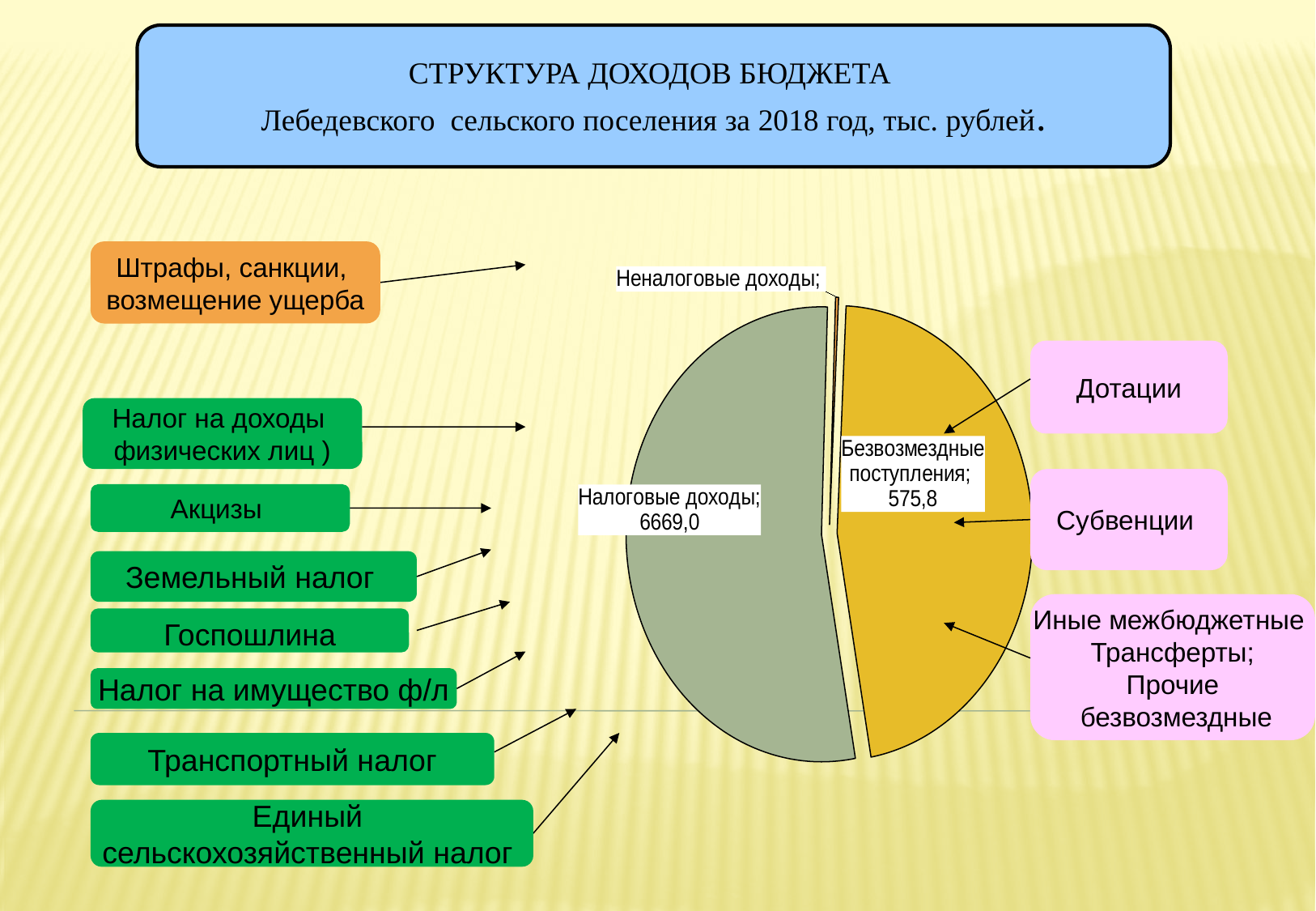
In what units are the values in the chart given? тыс. рублей What is the value for Налоговые доходы in the pie chart? 6669,0 Which category has the largest value in the pie chart? Налоговые доходы What is the value for Безвозмездные поступления in the pie chart? 575,8 What is the difference between Налоговые доходы and Безвозмездные поступления? 6093,2 How many slices does the pie chart have? 3 What kind of chart is shown on the slide? Pie chart What is the title of the chart on the slide? СТРУКТУРА ДОХОДОВ БЮДЖЕТА Лебедевского сельского поселения за 2018 год, тыс. рублей. Which is larger, Налоговые доходы or Безвозмездные поступления? Налоговые доходы Which slice of the pie chart is the smallest? Неналоговые доходы